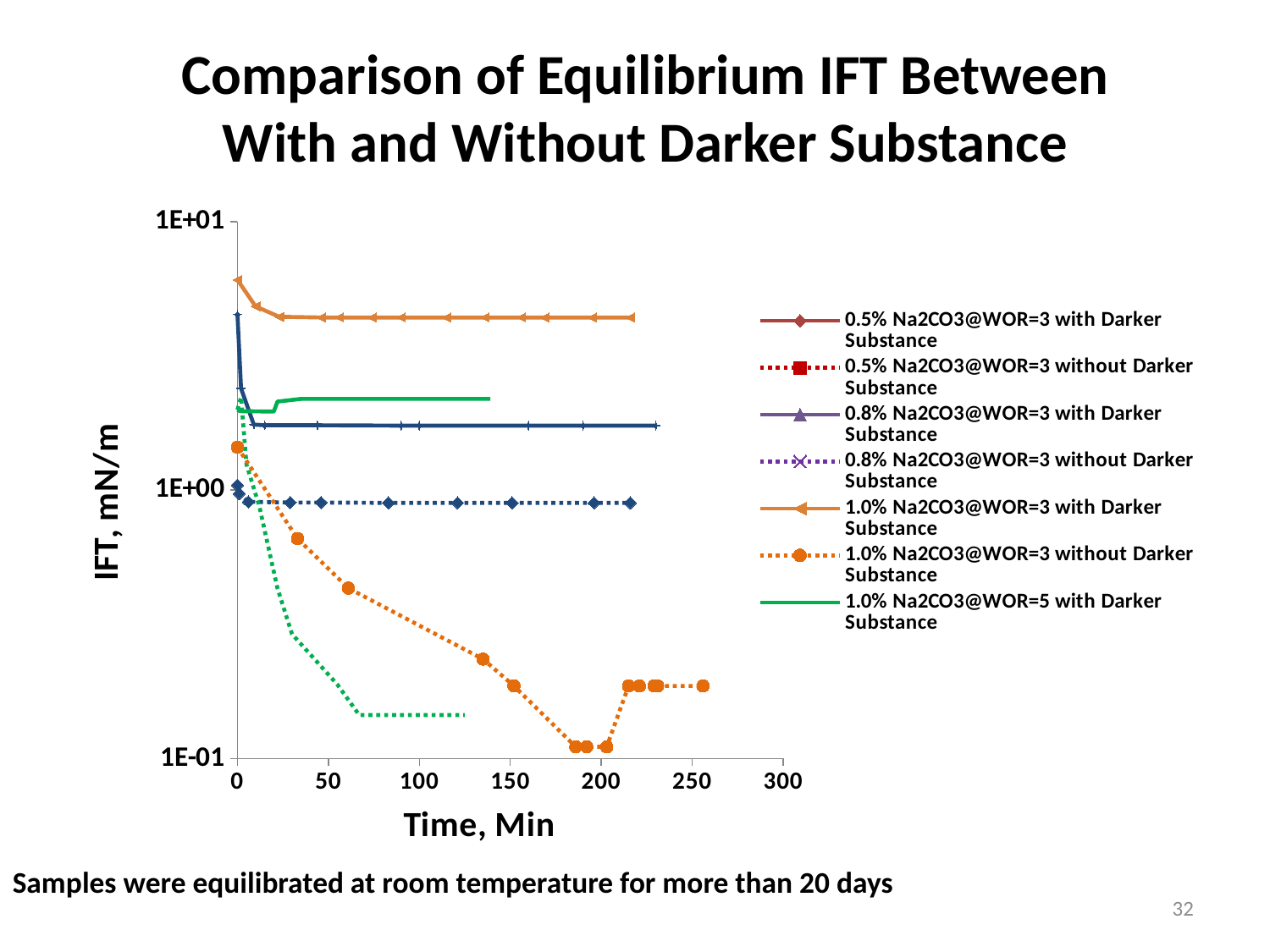
How many series does the legend list? 7 What is the label of the y axis? IFT, mN/m Is the IFT value for 1.0% Na2CO3@WOR=3 with Darker Substance at 200 minutes greater or less than 1E+00? greater What is the title of the chart? Comparison of Equilibrium IFT Between With and Without Darker Substance At 100 minutes, which has the higher IFT: 1.0% Na2CO3@WOR=3 with Darker Substance or 1.0% Na2CO3@WOR=3 without Darker Substance? 1.0% Na2CO3@WOR=3 with Darker Substance Is the IFT value for 1.0% Na2CO3@WOR=3 without Darker Substance at 200 minutes greater or less than 1E+00? less Is the IFT value for 1.0% Na2CO3@WOR=3 with Darker Substance at 50 minutes greater or less than 1E+01? less Does the IFT for 1.0% Na2CO3@WOR=3 without Darker Substance rise or fall over the first 150 minutes? fall Which series has the lowest IFT at 200 minutes? 1.0% Na2CO3@WOR=3 without Darker Substance Which series has the highest IFT at 200 minutes? 1.0% Na2CO3@WOR=3 with Darker Substance What kind of chart is shown on the slide? line chart